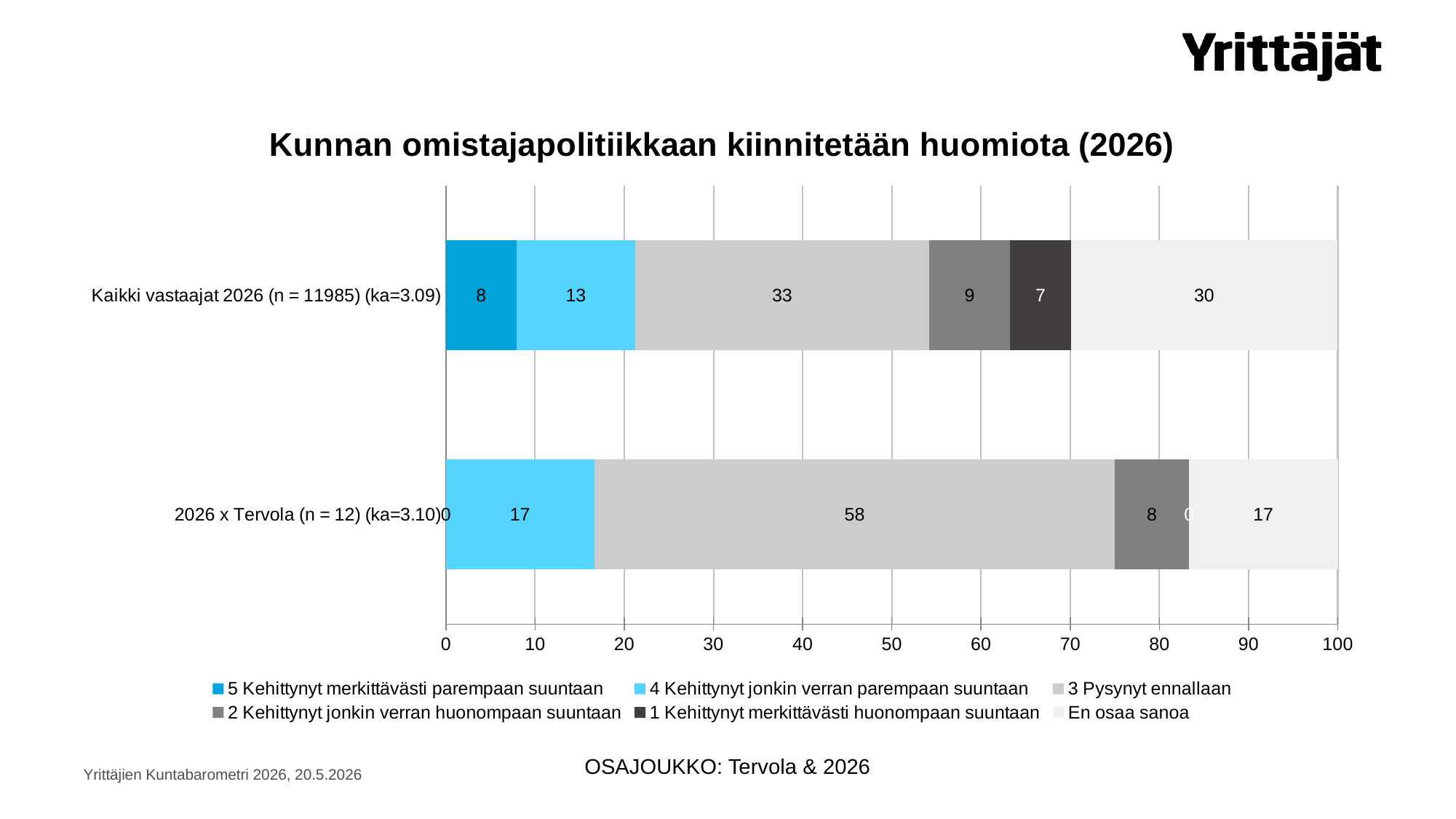
How many categories (bars) are shown in the chart? 2 What kind of chart is shown on the slide? Stacked bar chart What is the value for "En osaa sanoa" in the "Kaikki vastaajat 2026 (n = 11985) (ka=3.09)" bar? 30 What is the difference between the "3 Pysynyt ennallaan" values for "2026 x Tervola" and "Kaikki vastaajat 2026"? 25 How many series does the legend list? 6 Which segment is the largest in the "Kaikki vastaajat 2026 (n = 11985) (ka=3.09)" bar? 3 Pysynyt ennallaan What is the title of the chart? Kunnan omistajapolitiikkaan kiinnitetään huomiota (2026) What is the value for "5 Kehittynyt merkittävästi parempaan suuntaan" in the "2026 x Tervola (n = 12) (ka=3.10)" bar? 0 What is the value for "3 Pysynyt ennallaan" in the "Kaikki vastaajat 2026 (n = 11985) (ka=3.09)" bar? 33 What is the value for "4 Kehittynyt jonkin verran parempaan suuntaan" in the "2026 x Tervola (n = 12) (ka=3.10)" bar? 17 What is the value for "3 Pysynyt ennallaan" in the "2026 x Tervola (n = 12) (ka=3.10)" bar? 58 Which bar has the larger value for "En osaa sanoa": "Kaikki vastaajat 2026" or "2026 x Tervola"? Kaikki vastaajat 2026